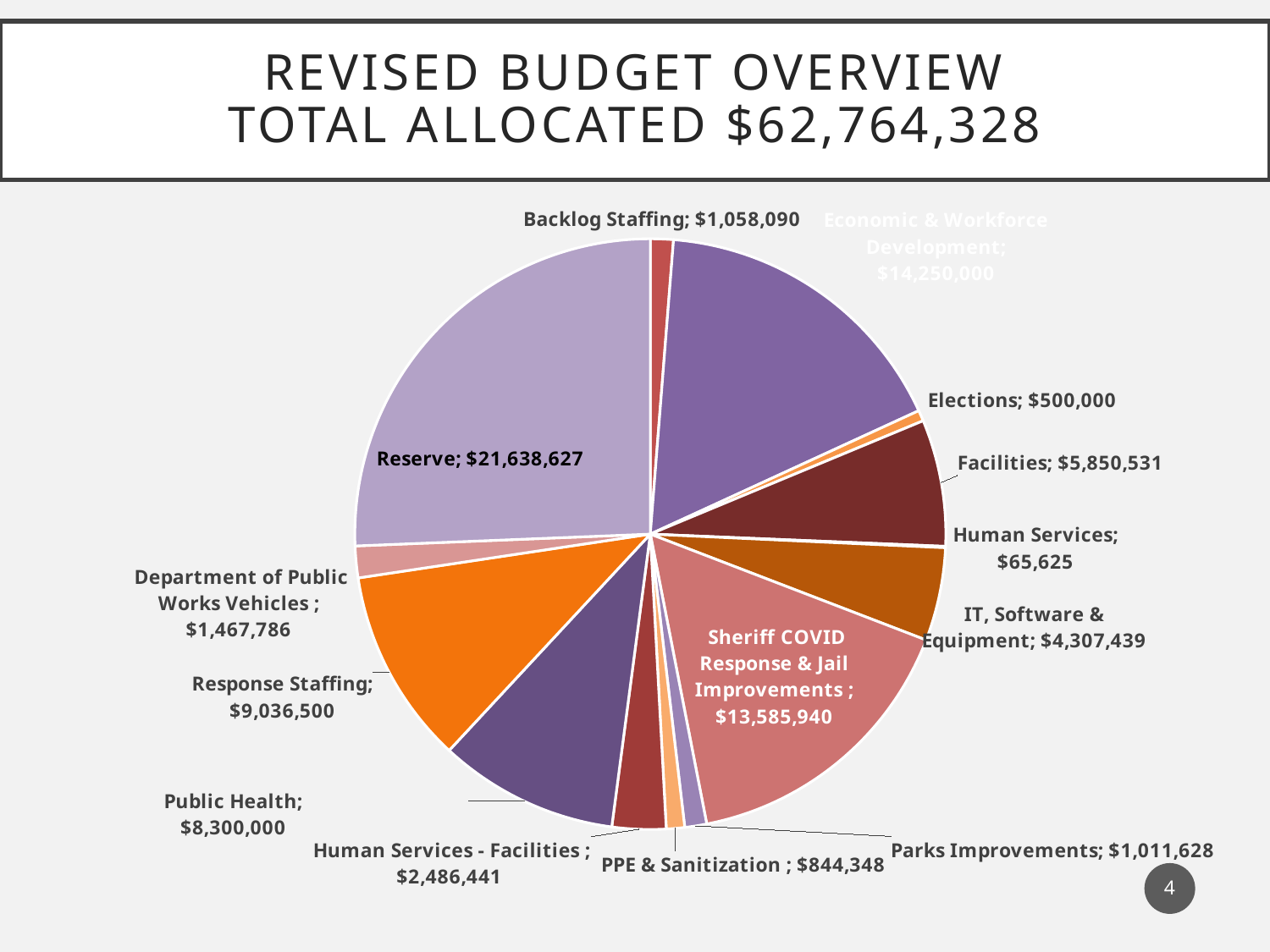
What is the difference between Economic & Workforce Development and Sheriff COVID Response & Jail Improvements? $664,060 What is the value for Reserve? $21,638,627 What is the value for PPE & Sanitization? $844,348 What is the difference between Response Staffing and Public Health? $736,500 Which category has the smallest value? Human Services What total allocated amount is stated in the slide title? $62,764,328 What kind of chart is shown on the slide? Pie chart Which is larger, Facilities or IT, Software & Equipment? Facilities What is the value for Sheriff COVID Response & Jail Improvements? $13,585,940 Which category has the largest slice of the pie? Reserve How many categories are shown in the pie chart? 14 What is the value for Elections? $500,000